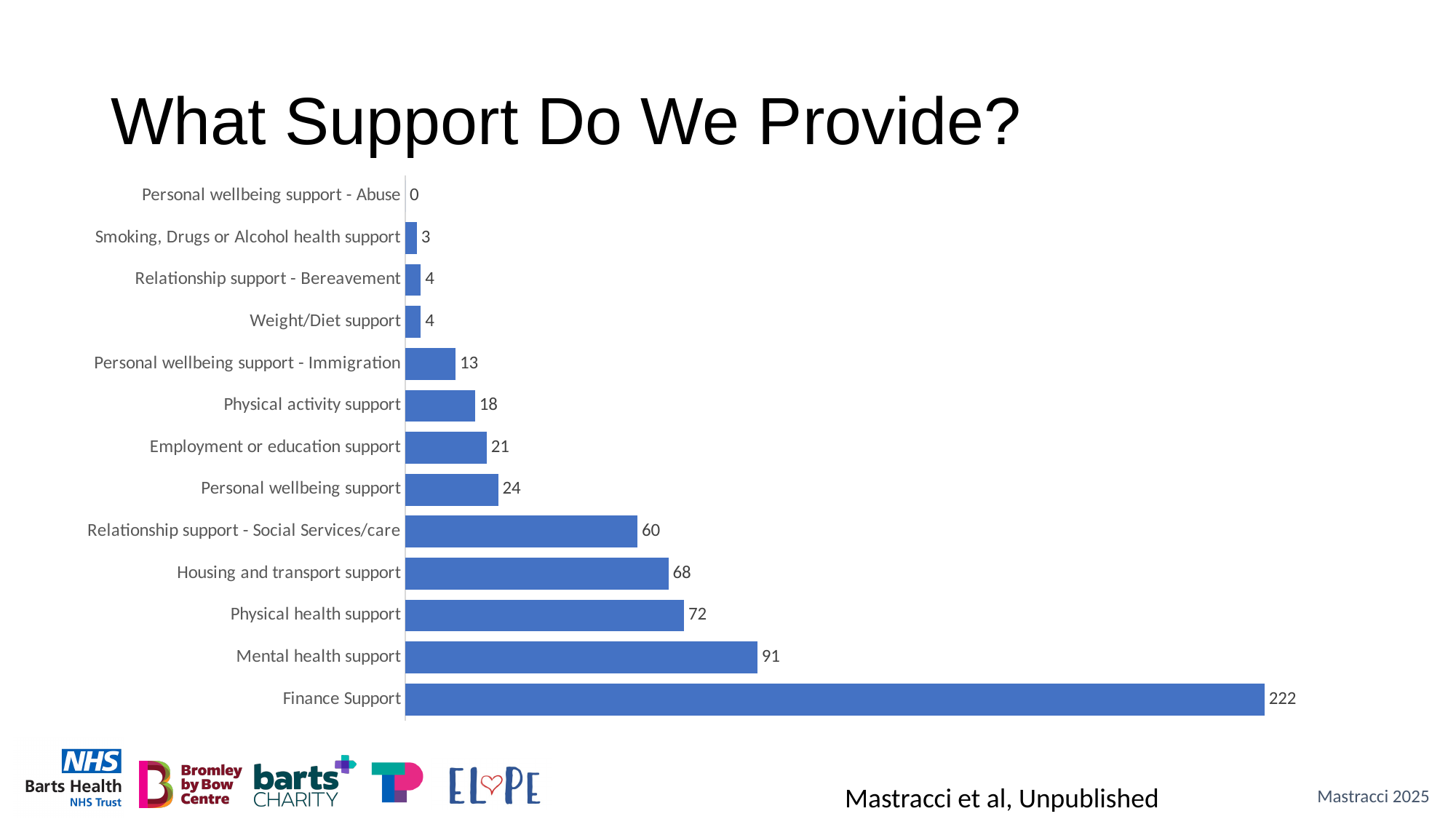
What kind of chart is shown on the slide? Bar chart How many categories are shown in the chart? 13 Which is larger, Physical health support or Housing and transport support? Physical health support What is the value for Mental health support? 91 What is the difference between Housing and transport support and Relationship support - Social Services/care? 8 Which category has the highest value? Finance Support Which category has the lowest value? Personal wellbeing support - Abuse What is the value for Personal wellbeing support - Immigration? 13 Which is larger, Employment or education support or Physical activity support? Employment or education support What is the value for Finance Support? 222 What is the difference between Finance Support and Mental health support? 131 What is the title of the slide? What Support Do We Provide?